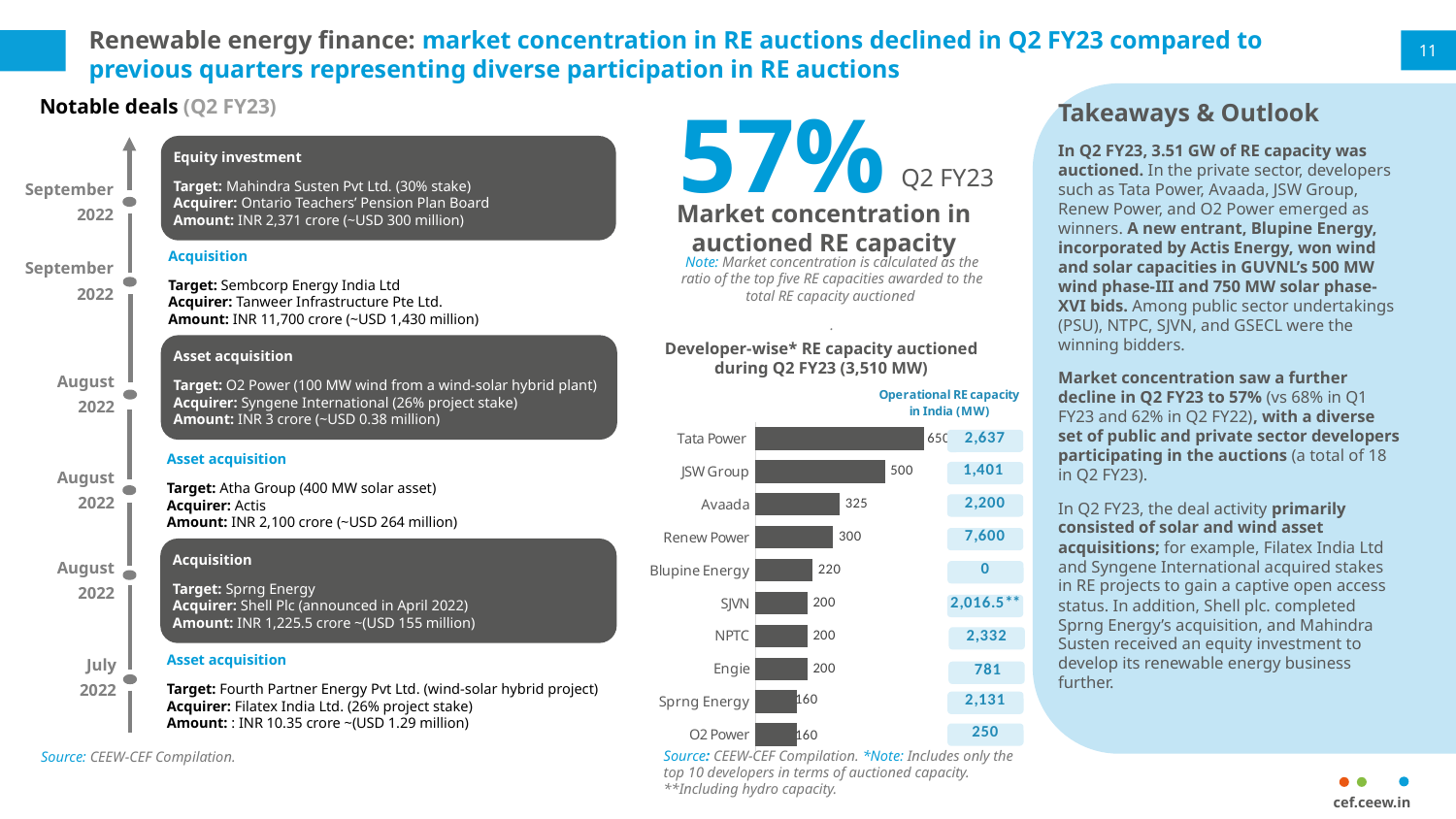
In the column next to the developer-wise chart, what is the operational RE capacity in India (MW) for Renew Power? 7,600 In the developer-wise RE capacity auctioned chart, what is the value for Blupine Energy? 220 In the developer-wise RE capacity auctioned chart, what is the value for JSW Group? 500 In the developer-wise RE capacity auctioned chart, what value is shown for Sprng Energy? 160 In the developer-wise RE capacity auctioned chart, what is the difference between Tata Power and JSW Group? 150 How many developers are shown in the developer-wise RE capacity auctioned chart? 10 What kind of chart is used to show developer-wise RE capacity auctioned during Q2 FY23? Bar chart In the developer-wise RE capacity auctioned chart, what is the value for Tata Power? 650 In the developer-wise RE capacity auctioned chart, what is the difference between Avaada and Renew Power? 25 In the developer-wise RE capacity auctioned chart, which is larger: Avaada or Blupine Energy? Avaada Which developer has the highest RE capacity auctioned in the developer-wise chart? Tata Power What total auctioned capacity is stated in the title of the developer-wise RE capacity chart? 3,510 MW